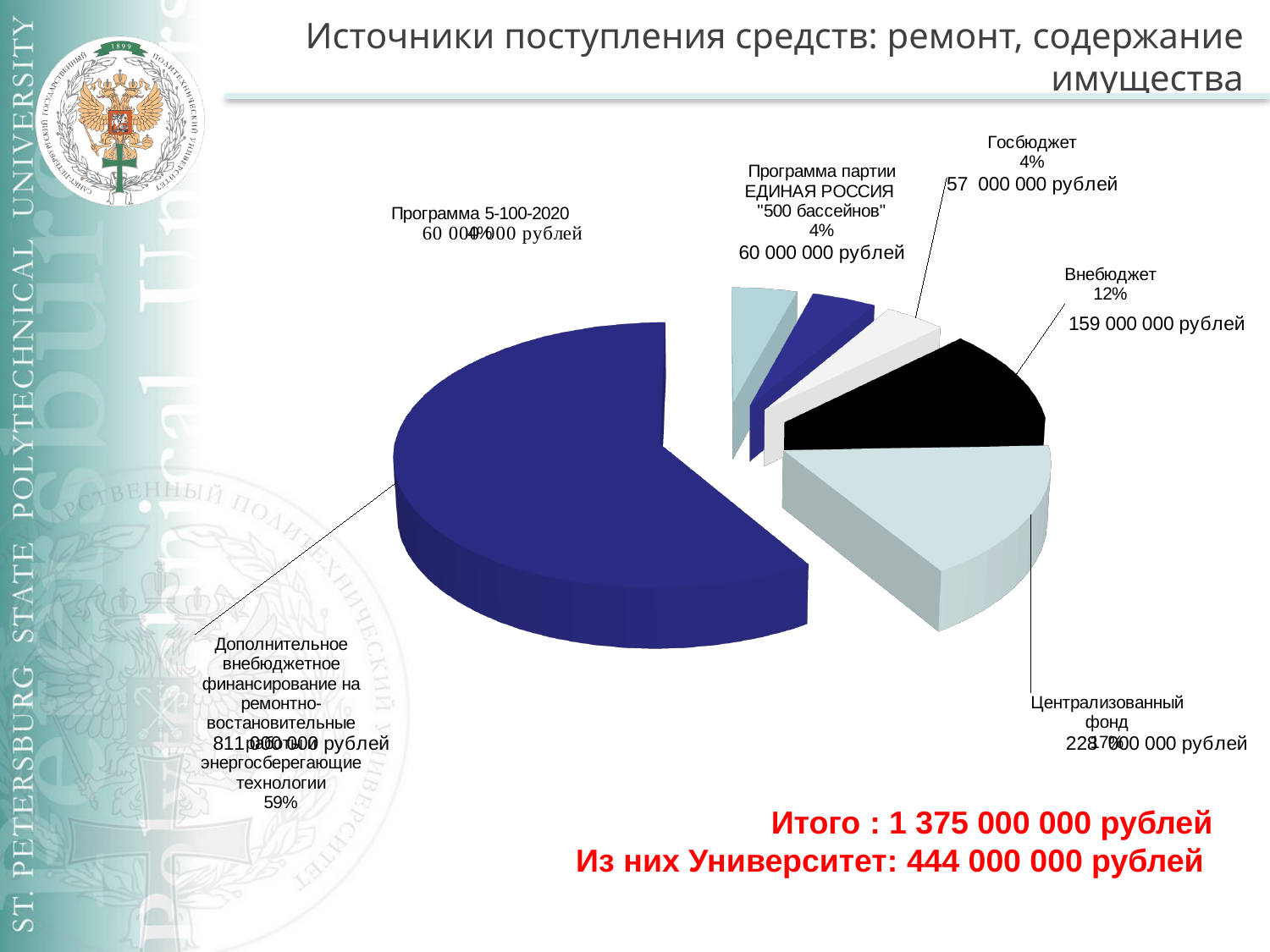
What share of the pie does Внебюджет represent? 12% What is the difference in rubles between Внебюджет and Госбюджет? 102 000 000 рублей What is the value in rubles for Программа партии ЕДИНАЯ РОССИЯ "500 бассейнов"? 60 000 000 рублей What share of the pie does the largest slice (Дополнительное внебюджетное финансирование) represent? 59% How many slices does the pie chart have? 6 What is the value in rubles for Госбюджет? 57 000 000 рублей What kind of chart is shown on the slide? pie chart Which category has the largest share of the pie? Дополнительное внебюджетное финансирование на ремонтно-востановительные работы и энергосберегающие технологии What share of the pie does Госбюджет represent? 4% What total amount (Итого) is stated on the slide? 1 375 000 000 рублей Which is larger: Внебюджет or Централизованный фонд? Централизованный фонд What is the value in rubles for Внебюджет? 159 000 000 рублей